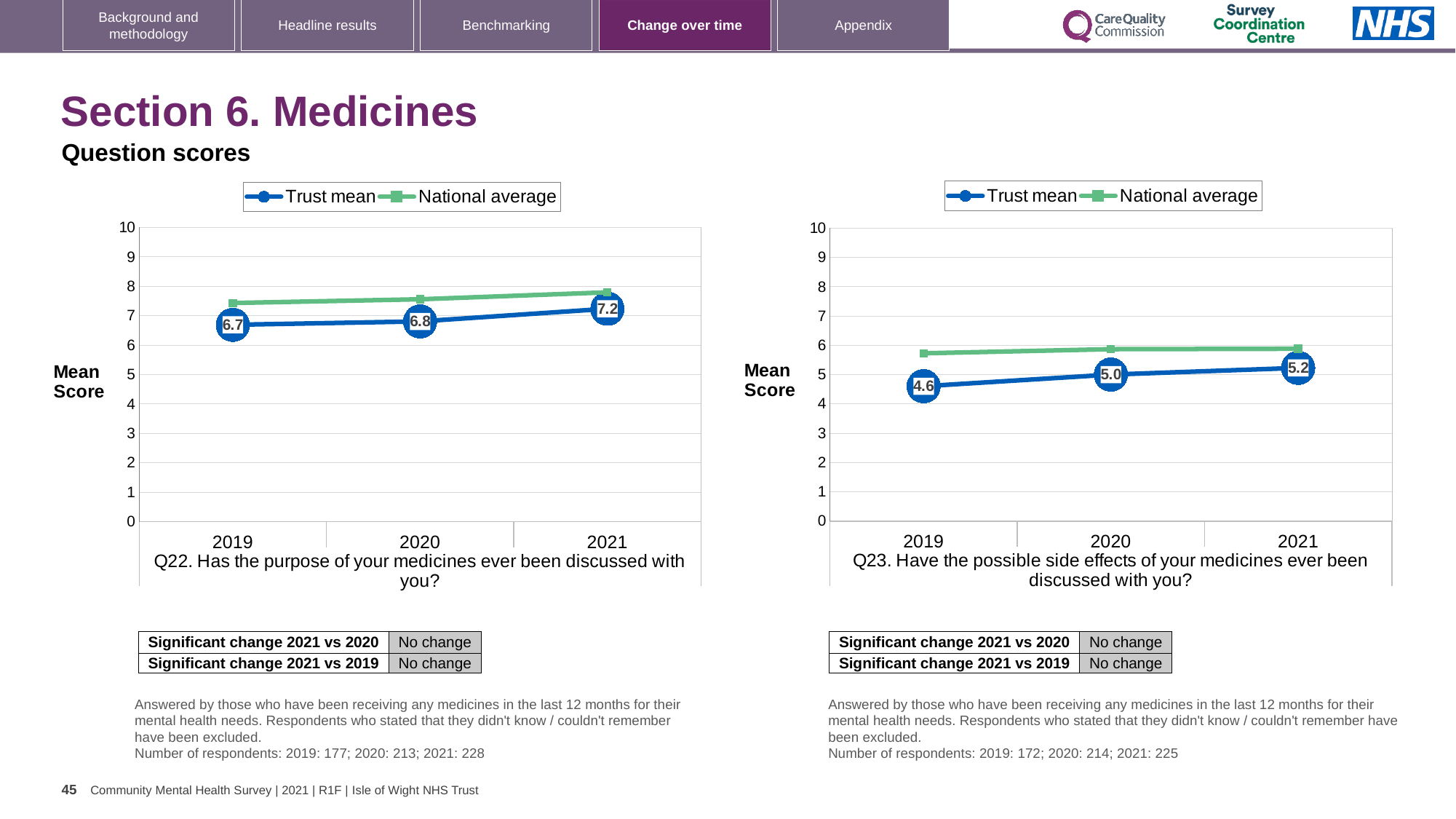
In the Q22 chart (left), what is the Trust mean for 2019? 6.7 In the Q22 chart (left), what is the Trust mean for 2021? 7.2 In the Q22 chart (left), which year has the highest Trust mean? 2021 What kind of chart is the Q22 chart (left)? line chart In the Q23 chart (right), does the Trust mean rise or fall from 2019 to 2021? rise In the Q23 chart (right), what is the difference between the Trust mean in 2021 and in 2020? 0.2 In the Q23 chart (right), which year has the lowest Trust mean? 2019 How many series does the legend of the Q23 chart (right) list? 2 In the Q23 chart (right), what is the Trust mean for 2019? 4.6 In the Q22 chart (left), what is the difference between the Trust mean in 2021 and in 2019? 0.5 In the Q23 chart (right), what is the Trust mean for 2020? 5.0 In the Q22 chart (left), is the National average for 2021 greater or less than 7? greater